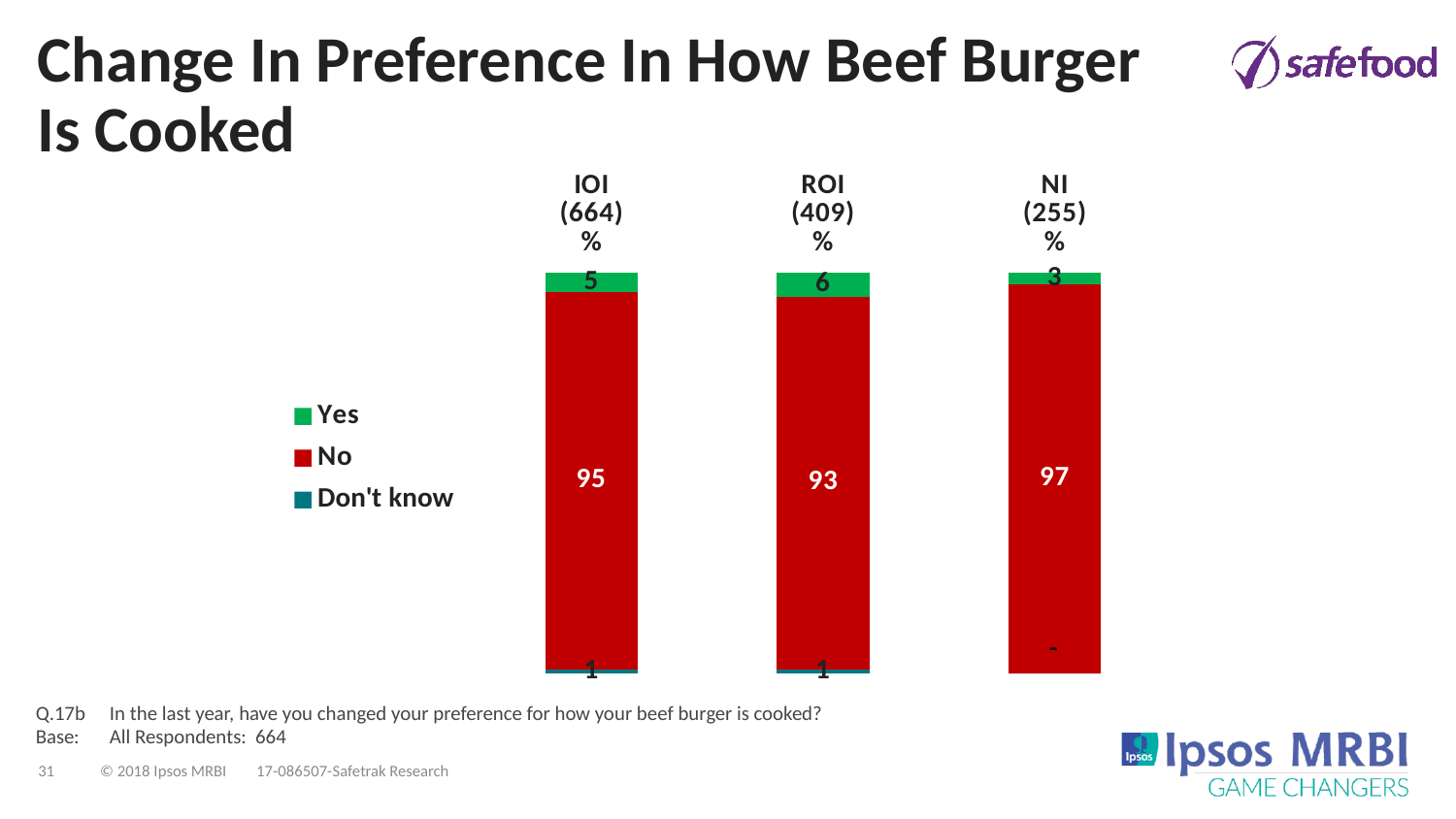
What is the base size shown for ROI? 409 How many series does the legend list? 3 How many regions are shown in the chart? 3 What percentage of IOI respondents answered "No"? 95 What is the "Don't know" value for IOI? 1 Which region has the lowest "Yes" percentage? NI What percentage of ROI respondents answered "Yes"? 6 Is the "Yes" percentage higher for IOI or ROI? ROI Which region has the highest "No" percentage? NI What type of chart is shown on the slide? Stacked bar chart What percentage of NI respondents answered "No"? 97 What is the difference between the "No" percentages for NI and ROI? 4